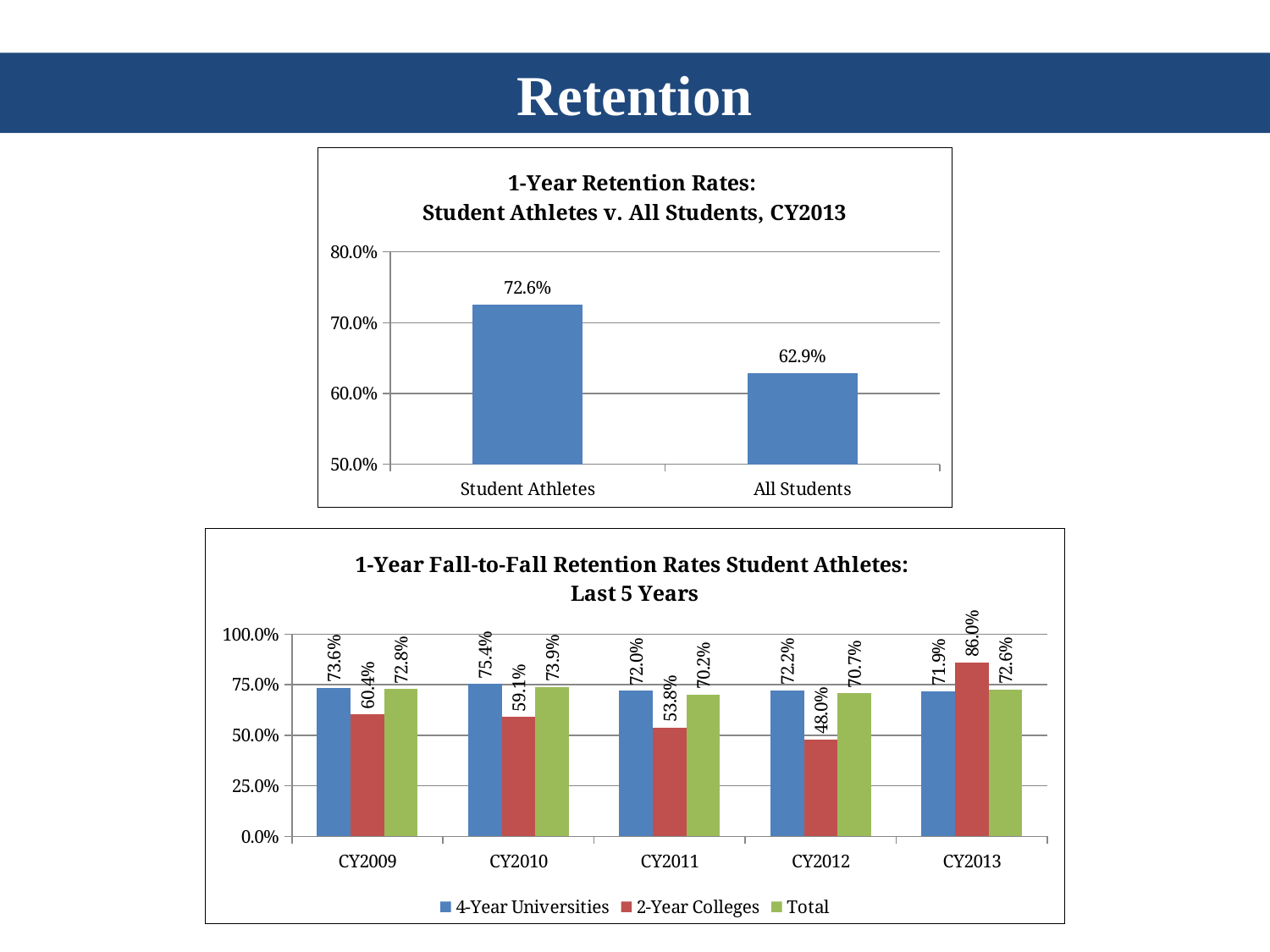
What kind of chart is the bottom chart (1-Year Fall-to-Fall Retention Rates Student Athletes: Last 5 Years)? Bar chart In the bottom chart (1-Year Fall-to-Fall Retention Rates Student Athletes: Last 5 Years), which year has the lowest 2-Year Colleges retention rate? CY2012 In the bottom chart (1-Year Fall-to-Fall Retention Rates Student Athletes: Last 5 Years), how many series does the legend list? 3 In the bottom chart (1-Year Fall-to-Fall Retention Rates Student Athletes: Last 5 Years), what is the difference between the 2-Year Colleges rates for CY2013 and CY2012? 38.0% In the top chart (1-Year Retention Rates: Student Athletes v. All Students, CY2013), how many categories are shown? 2 In the top chart (1-Year Retention Rates: Student Athletes v. All Students, CY2013), what is the retention rate for Student Athletes? 72.6% In the bottom chart (1-Year Fall-to-Fall Retention Rates Student Athletes: Last 5 Years), what is the 4-Year Universities retention rate for CY2010? 75.4% In the top chart (1-Year Retention Rates: Student Athletes v. All Students, CY2013), what is the difference between the Student Athletes and All Students retention rates? 9.7% In the bottom chart (1-Year Fall-to-Fall Retention Rates Student Athletes: Last 5 Years), what is the 2-Year Colleges retention rate for CY2013? 86.0% In the bottom chart (1-Year Fall-to-Fall Retention Rates Student Athletes: Last 5 Years), is the Total rate for CY2011 greater or less than 75.0%? less In the bottom chart (1-Year Fall-to-Fall Retention Rates Student Athletes: Last 5 Years), which year has the highest Total retention rate? CY2010 In the top chart (1-Year Retention Rates: Student Athletes v. All Students, CY2013), what is the retention rate for All Students? 62.9%